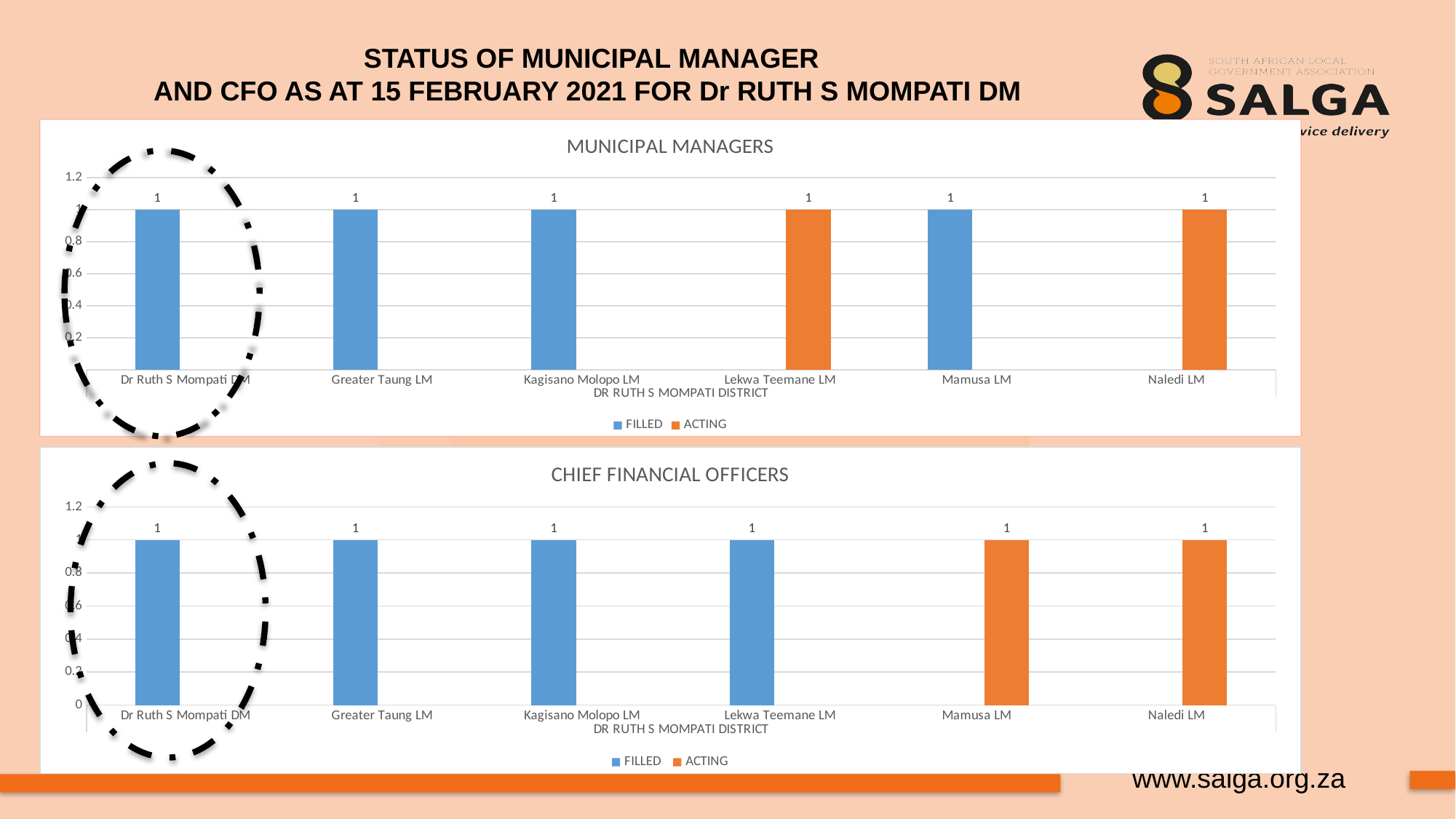
In the MUNICIPAL MANAGERS chart, which series does the bar for Lekwa Teemane LM belong to? ACTING In the CHIEF FINANCIAL OFFICERS chart, is the value for Kagisano Molopo LM greater or less than 0.6? greater In the CHIEF FINANCIAL OFFICERS chart, which series does the bar for Mamusa LM belong to? ACTING How many municipalities are shown on the x axis of the MUNICIPAL MANAGERS chart? 6 In the MUNICIPAL MANAGERS chart, what is the difference between the values for Dr Ruth S Mompati DM and Naledi LM? 0 In the MUNICIPAL MANAGERS chart, is the value for Mamusa LM greater or less than 0.8? greater In the CHIEF FINANCIAL OFFICERS chart, what is the value shown for Naledi LM? 1 How many series does the legend of the MUNICIPAL MANAGERS chart list? 2 How many categories are plotted in the CHIEF FINANCIAL OFFICERS chart? 6 What kind of chart is the CHIEF FINANCIAL OFFICERS chart? Bar chart In the CHIEF FINANCIAL OFFICERS chart, what is the value shown for Lekwa Teemane LM? 1 In the MUNICIPAL MANAGERS chart, what is the value shown for Greater Taung LM? 1